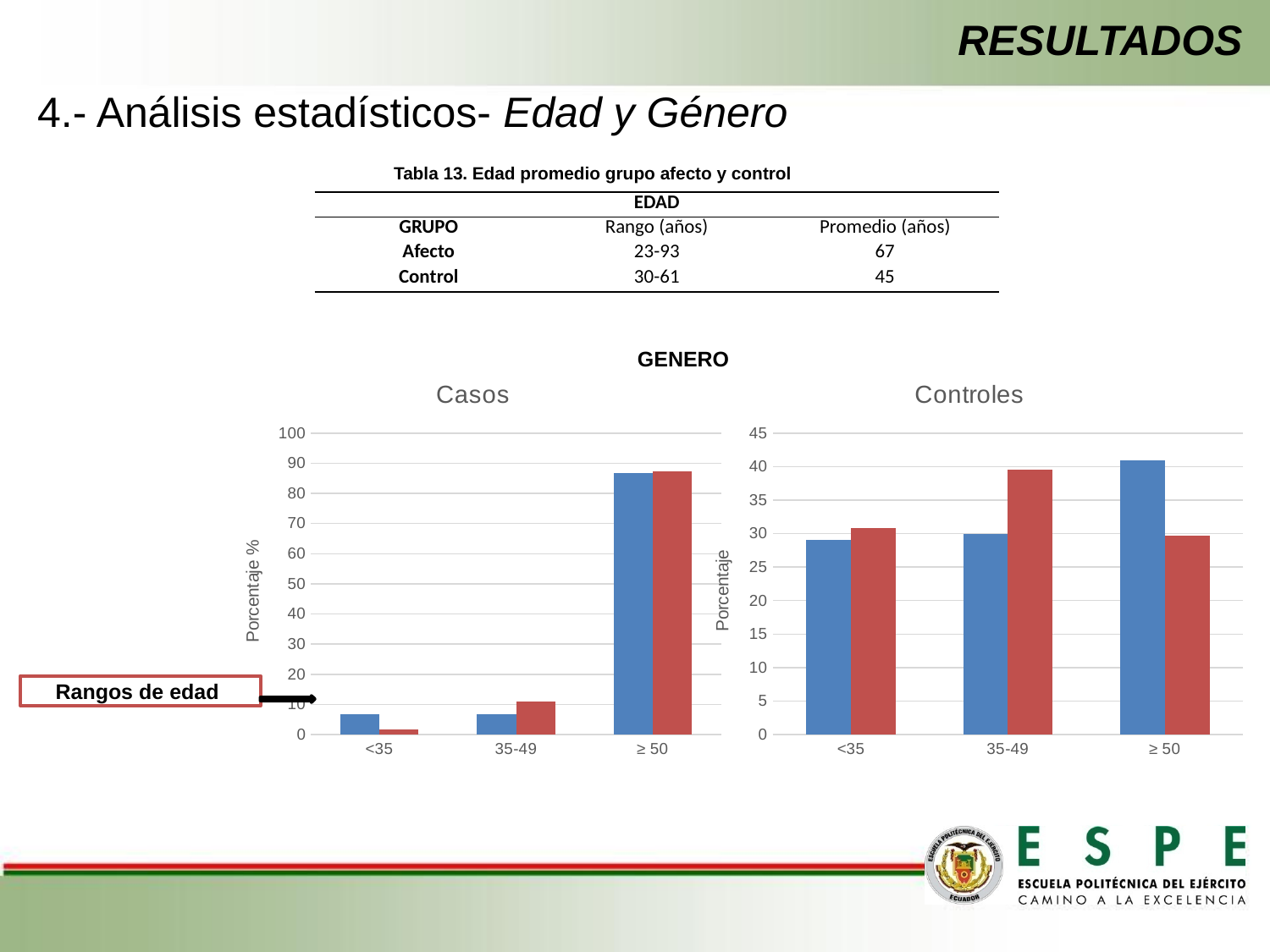
In the "Casos" chart, is the blue bar for ≥ 50 greater or less than 80? greater In the "Casos" chart, is the red bar for 35-49 greater or less than 20? less How many age-range categories are shown on the x axis of the "Controles" chart? 3 In the "Casos" chart, for the 35-49 age range, which bar is taller, the blue one or the red one? red In the "Casos" chart, which age range has the lowest red bar? <35 In the "Controles" chart, for the ≥ 50 age range, which bar is taller, the blue one or the red one? blue In the "Controles" chart, is the red bar for 35-49 greater or less than 35? greater In the "Controles" chart, which age range has the highest red bar? 35-49 In the "Controles" chart, which age range has the highest blue bar? ≥ 50 What is the title of the chart on the right side of the slide? Controles What kind of chart is the "Casos" chart? bar chart In the "Casos" chart, which age range has the highest blue bar? ≥ 50